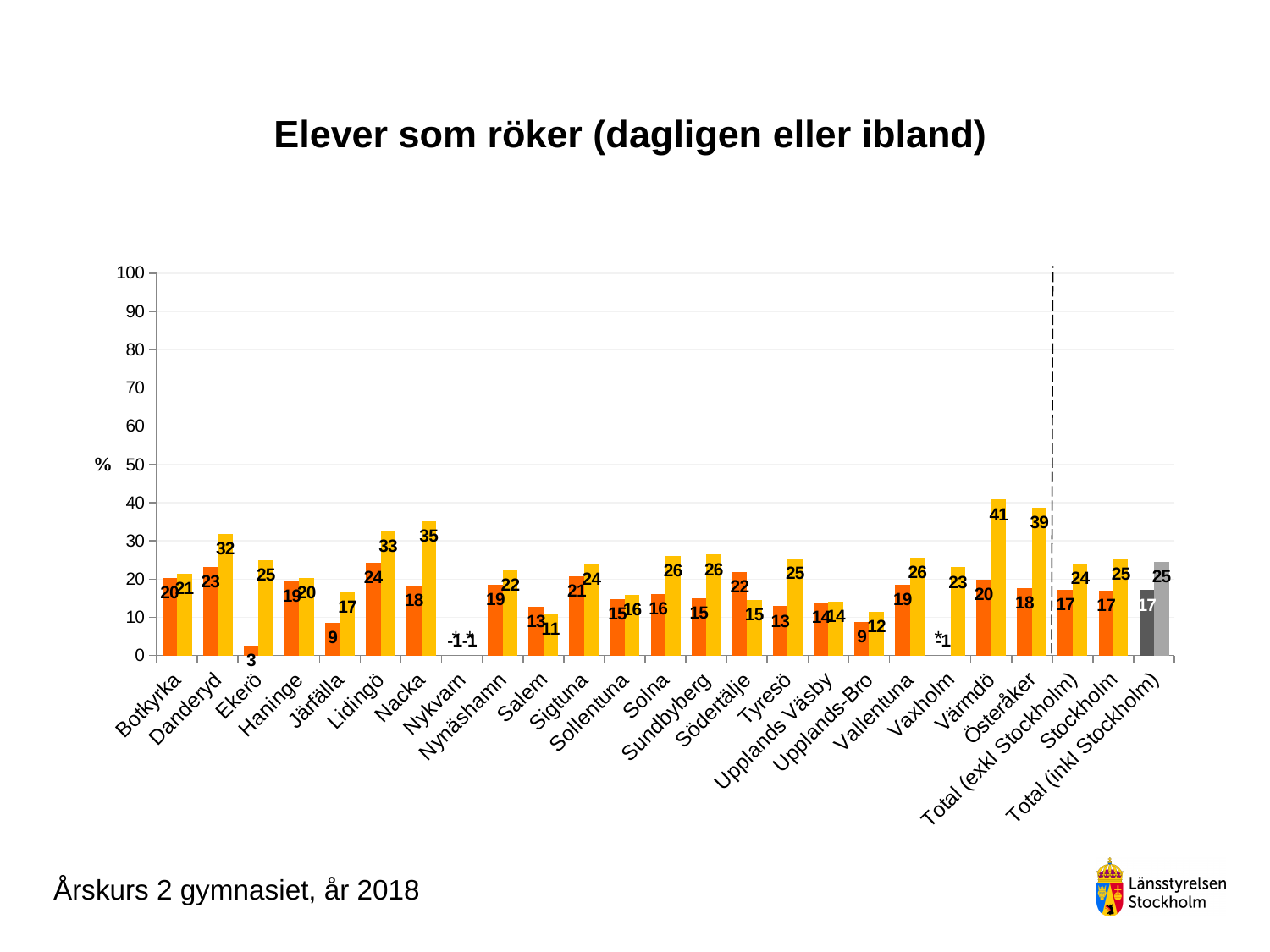
What is the value of the orange bar for Stockholm? 17 What kind of chart is shown on the slide? bar chart What is the value of the light grey bar for Total (inkl Stockholm)? 25 Which municipality has the highest yellow bar? Värmdö Is the value of the yellow bar for Österåker greater or less than 30? greater Which is larger for Södertälje, the orange bar or the yellow bar? the orange bar What is the difference between the yellow bar and the orange bar for Danderyd? 9 What is the value of the yellow bar for Värmdö? 41 What is the title of the chart? Elever som röker (dagligen eller ibland) What is the value of the orange bar for Lidingö? 24 Which municipality has the lowest orange bar with a positive value? Ekerö What is the value of the yellow bar for Nacka? 35